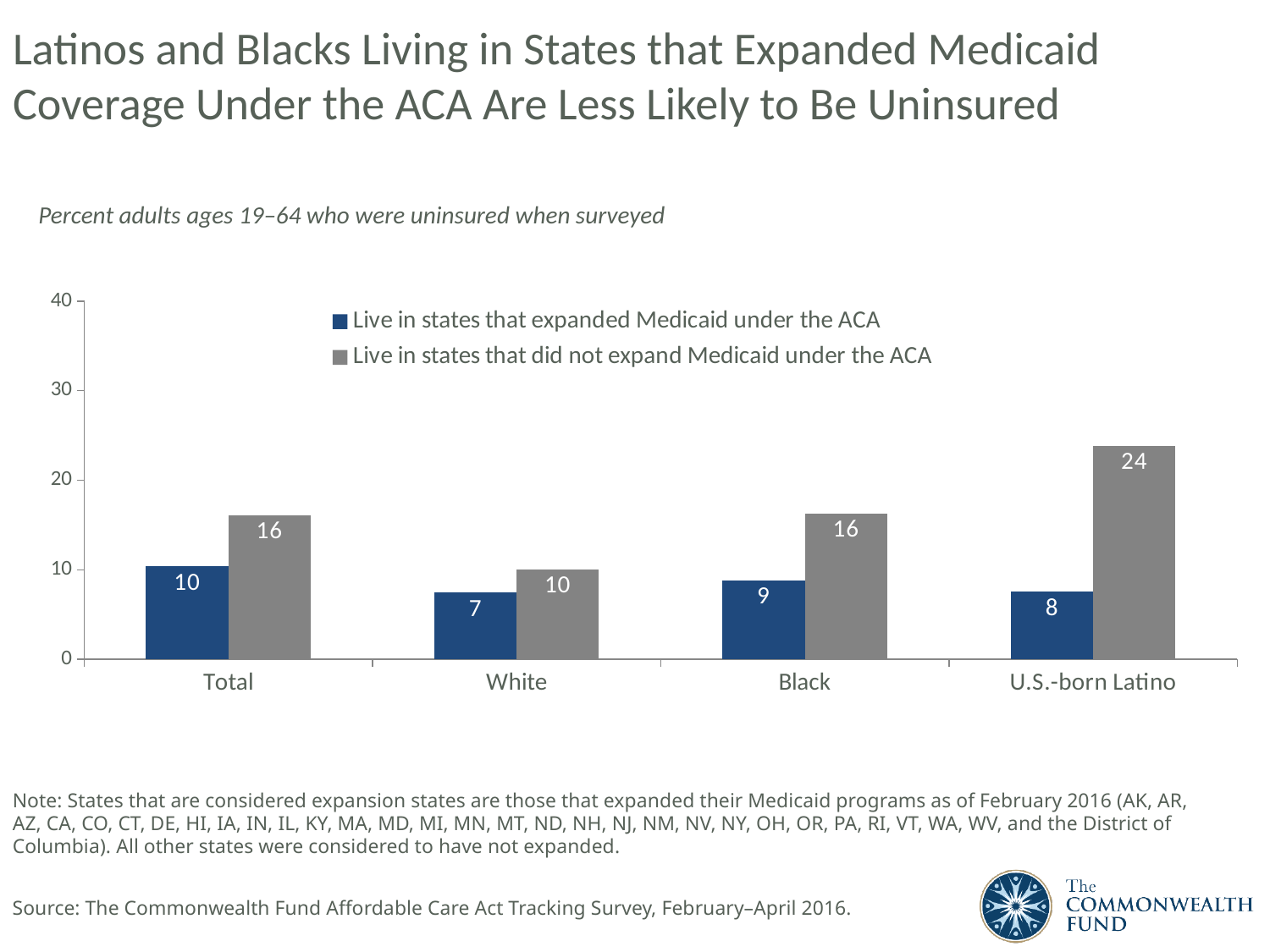
What is the value for White adults living in states that expanded Medicaid under the ACA? 7 Which is larger: the value for Black adults in expansion states or the value for Black adults in non-expansion states? Non-expansion states How many categories are shown on the x axis? 4 What is the value for U.S.-born Latino adults living in states that did not expand Medicaid under the ACA? 24 What is the value for Black adults living in states that did not expand Medicaid under the ACA? 16 Which category has the lowest value among those living in states that expanded Medicaid under the ACA? White How many series does the legend list? 2 What is the difference between the non-expansion and expansion values for the Total category? 6 What kind of chart is shown on the slide? Bar chart What is the difference between the non-expansion and expansion values for U.S.-born Latino adults? 16 Which category has the highest value among those living in states that did not expand Medicaid under the ACA? U.S.-born Latino Is the value for U.S.-born Latino adults in non-expansion states greater or less than 20? greater